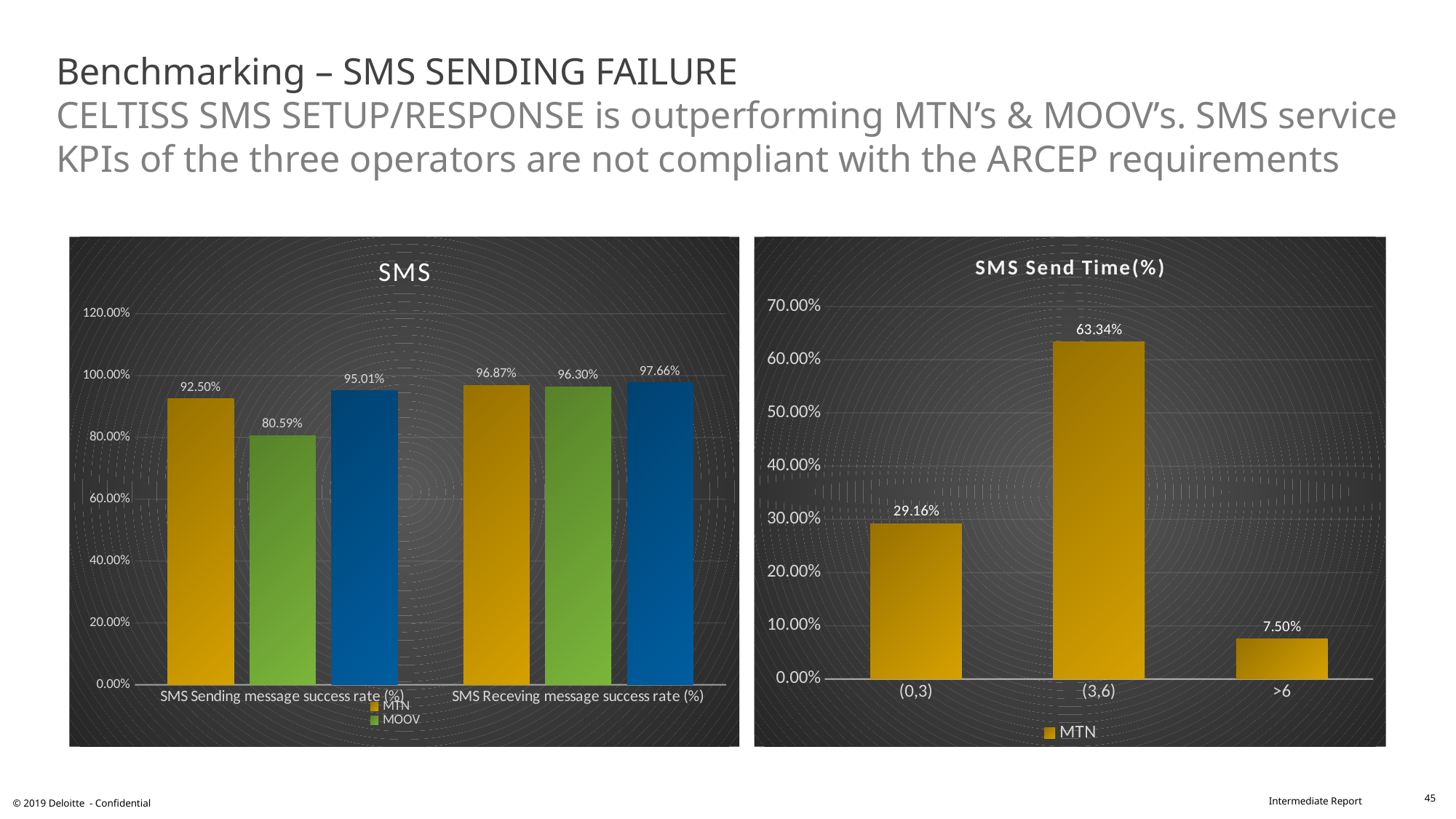
How many categories are shown on the x axis of the SMS Send Time(%) chart on the right? 3 What kind of chart is the SMS Send Time(%) chart on the right? Bar chart In the SMS Send Time(%) chart on the right, which category has the highest value? (3,6) In the SMS chart on the left, what is the MTN value for SMS Receving message success rate (%)? 96.87% In the SMS chart on the left, what is the MOOV value for SMS Sending message success rate (%)? 80.59% In the SMS Send Time(%) chart on the right, what is the value for (0,3)? 29.16% In the SMS chart on the left, what is the MTN value for SMS Sending message success rate (%)? 92.50% In the SMS chart on the left, what is the difference between the MTN and MOOV values for SMS Sending message success rate (%)? 11.91% In the SMS chart on the left, which is larger for SMS Sending message success rate (%): MTN or MOOV? MTN In the SMS Send Time(%) chart on the right, what is the difference between the values for (3,6) and (0,3)? 34.18% In the SMS Send Time(%) chart on the right, what is the value for >6? 7.50% In the SMS Send Time(%) chart on the right, which category has the lowest value? >6